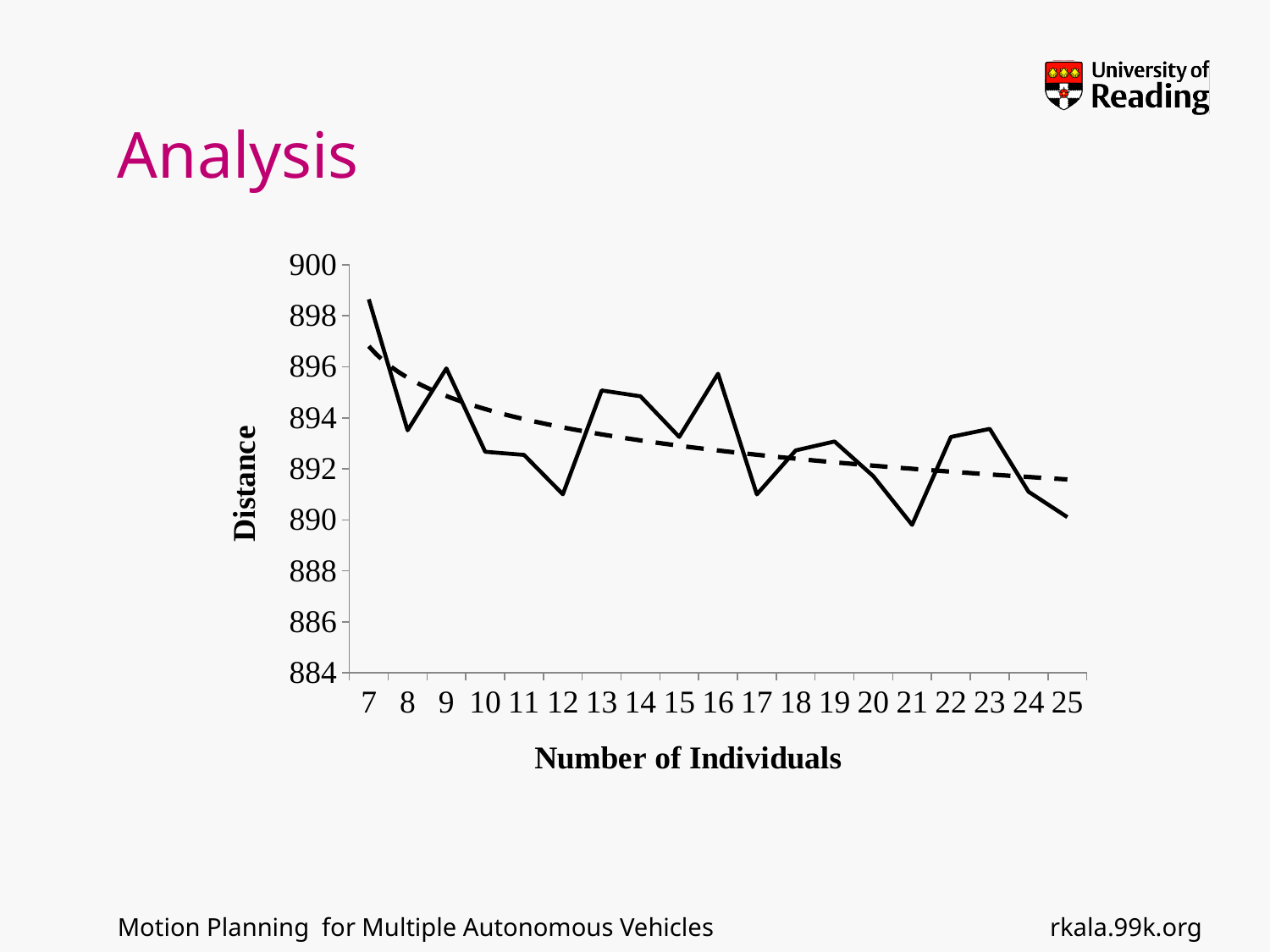
What is the label of the y axis? Distance Which has the larger distance on the solid line, 16 individuals or 17 individuals? 16 At which number of individuals is the distance on the solid line highest? 7 Which has the larger distance on the solid line, 7 individuals or 25 individuals? 7 Is the distance for 25 individuals greater or less than 892? less What is the label of the x axis? Number of Individuals Is the distance for 16 individuals greater or less than 894? greater How many data points does the solid line plot along the x axis? 19 Is the distance for 12 individuals greater or less than 892? less Do the values of the solid line generally rise or fall as the number of individuals increases? fall What kind of chart is shown on the slide? line chart